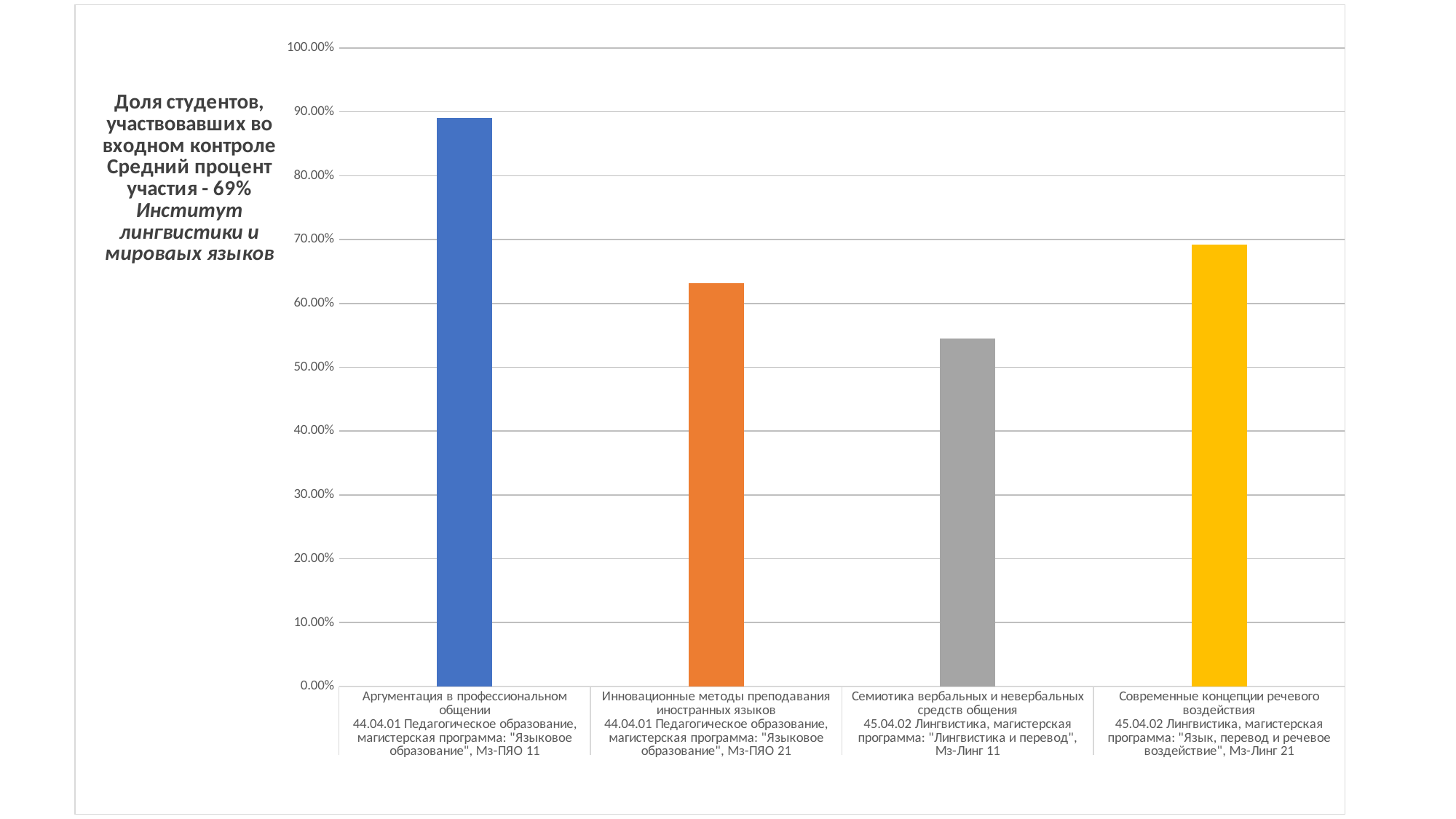
Which is larger: the value for Инновационные методы преподавания иностранных языков (Мз-ПЯО 21) or the value for Современные концепции речевого воздействия (Мз-Линг 21)? Современные концепции речевого воздействия (Мз-Линг 21) Do the values rise or fall across the first three bars from left to right? fall What kind of chart is shown on the slide? bar chart Is the value for Инновационные методы преподавания иностранных языков (Мз-ПЯО 21) greater or less than 70.00%? less Is the value for Аргументация в профессиональном общении (Мз-ПЯО 11) greater or less than 80.00%? greater Is the value for Современные концепции речевого воздействия (Мз-Линг 21) greater or less than 60.00%? greater What average participation percentage is stated in the chart title? 69% Which category has the lowest value? Семиотика вербальных и невербальных средств общения (Мз-Линг 11) Which category has the highest value? Аргументация в профессиональном общении (Мз-ПЯО 11) How many bars (categories) does the chart show? 4 Which is larger: the value for Семиотика вербальных и невербальных средств общения (Мз-Линг 11) or the value for Аргументация в профессиональном общении (Мз-ПЯО 11)? Аргументация в профессиональном общении (Мз-ПЯО 11)